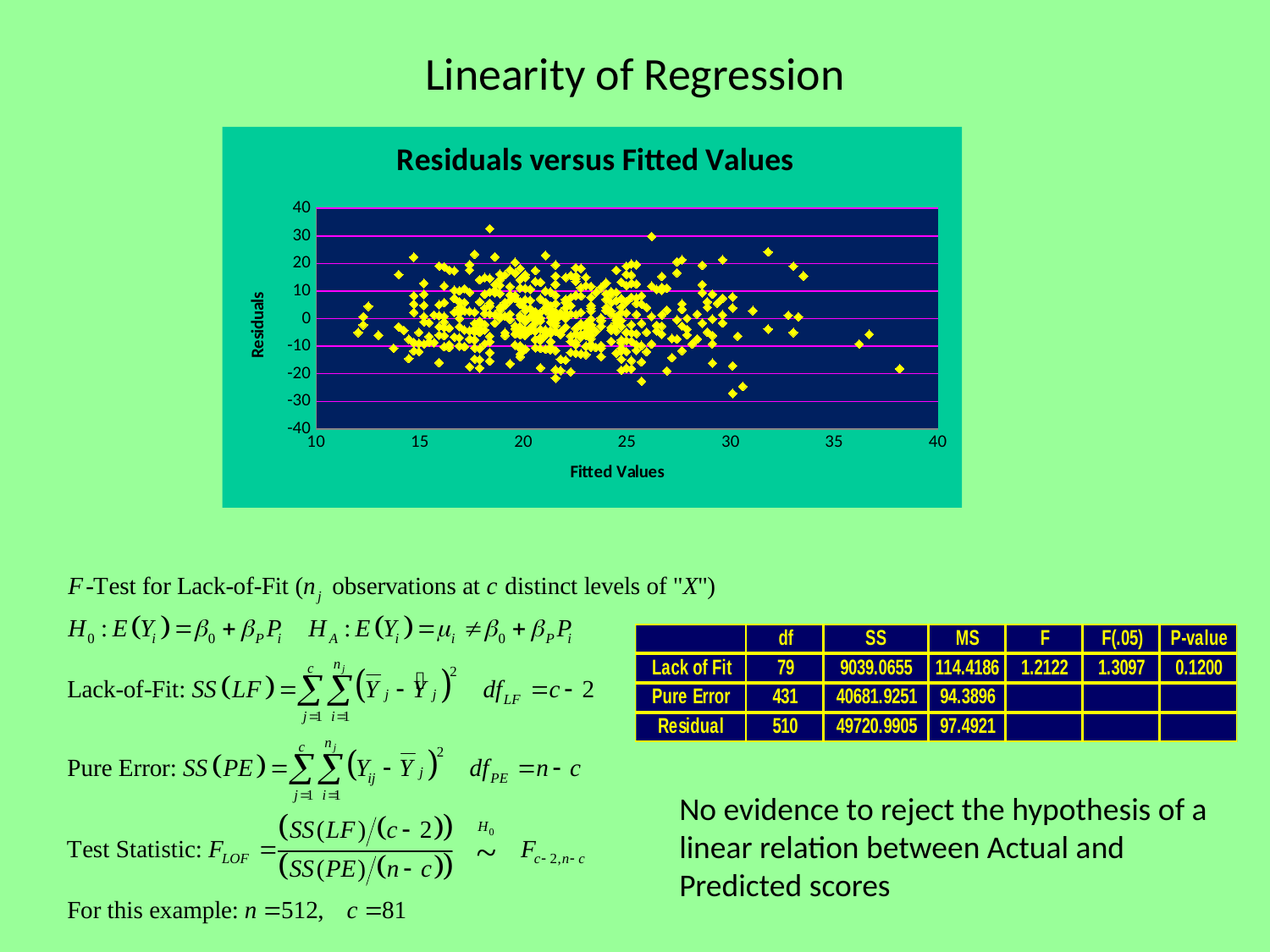
Is the fitted value of the rightmost point in the chart greater or less than 35? greater What kind of chart is shown on the slide? scatter chart What is the label of the horizontal axis of the chart? Fitted Values Is the highest residual plotted in the chart greater or less than 30? greater What is the title of the chart on the slide? Residuals versus Fitted Values Are all residuals in the chart less than 40? Yes